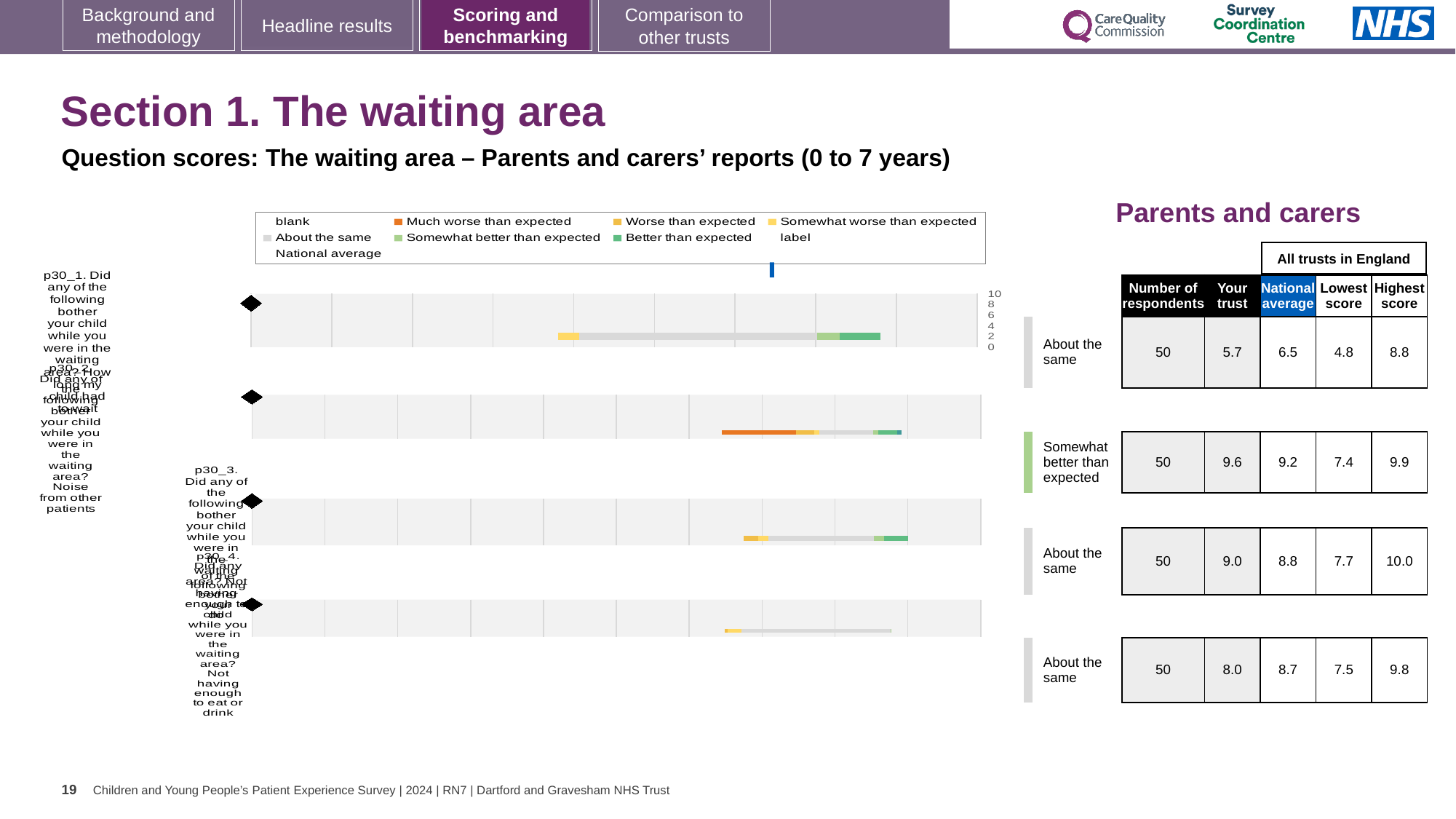
What kind of chart is shown on the slide? bar chart In the table beside the chart, what is the highest score for the third row (p30_3, not having enough to do)? 10.0 Which legend entry is shown in orange? Much worse than expected In the table beside the chart, what is the lowest score for the fourth row (p30_4, not having enough to eat or drink)? 7.5 Which legend entry is shown in grey? About the same How many question categories (rows) are plotted in the chart? 4 For the second row (p30_2), what is the difference between the 'Your trust' score and the national average? 0.4 In the table beside the chart, what is the 'Your trust' score for the first row (p30_1, how long my child had to wait)? 5.7 Which row has the lowest 'Your trust' score in the table beside the chart? p30_1 (How long my child had to wait) In the table beside the chart, what is the national average for the second row (p30_2, noise from other patients)? 9.2 How many entries does the chart legend list? 9 Which row has the highest 'Your trust' score in the table beside the chart? p30_2 (Noise from other patients)